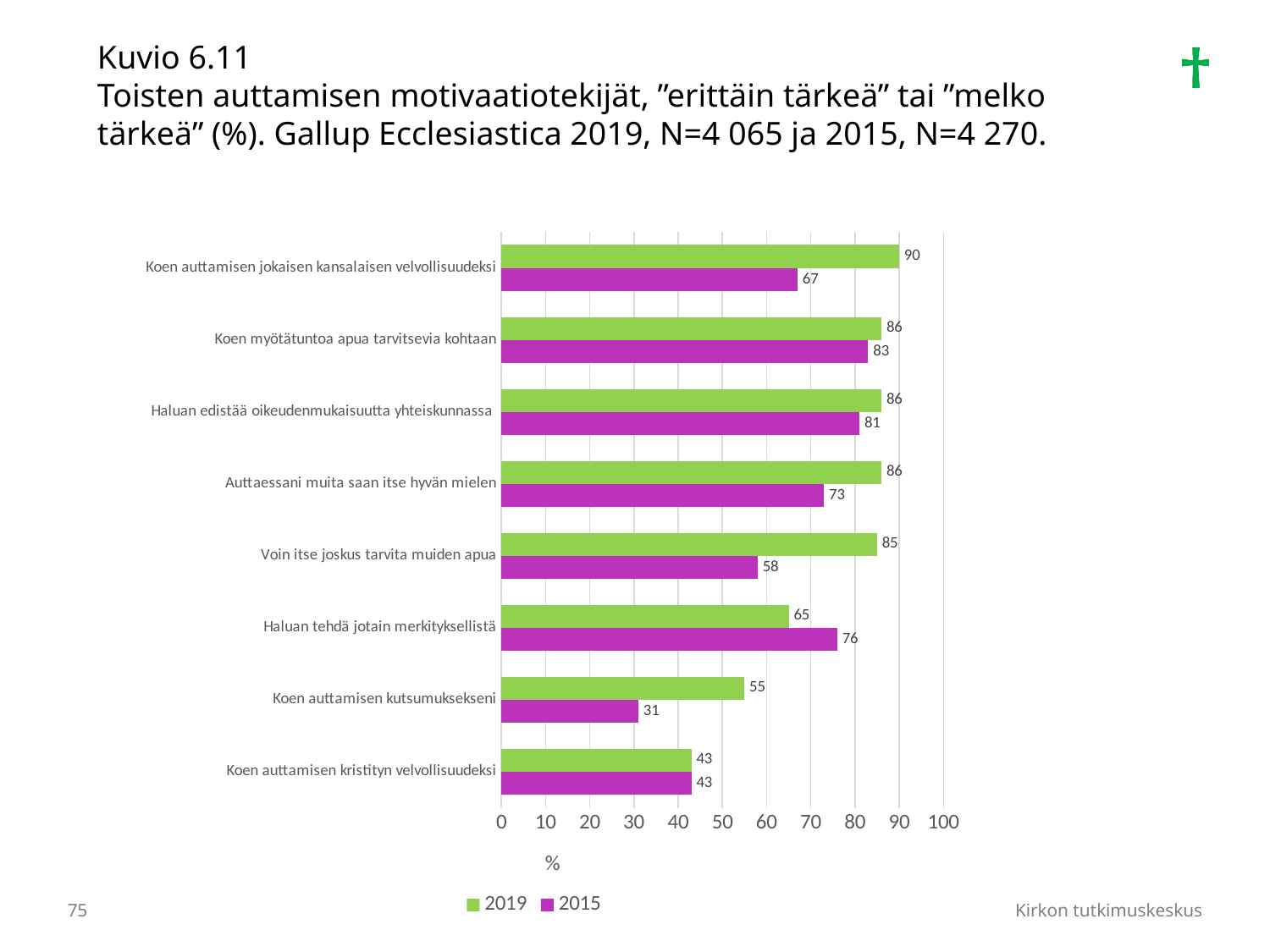
Which colour represents the 2015 series in the chart? Purple What kind of chart is shown on the slide? Bar chart What is the 2015 value for "Koen auttamisen kutsumukseksi"? 31 Which category has the highest 2019 value? Koen auttamisen jokaisen kansalaisen velvollisuudeksi What is the 2019 value for "Koen auttamisen kristityn velvollisuudeksi"? 43 What is the 2019 value for "Koen auttamisen jokaisen kansalaisen velvollisuudeksi"? 90 How many series does the legend list? 2 For "Haluan tehdä jotain merkityksellistä", which year has the larger value, 2019 or 2015? 2015 What is the difference between the 2019 and 2015 values for "Voin itse joskus tarvita muiden apua"? 27 Which category has the lowest 2015 value? Koen auttamisen kutsumuksekseni What is the 2015 value for "Voin itse joskus tarvita muiden apua"? 58 How many categories are shown in the chart? 8